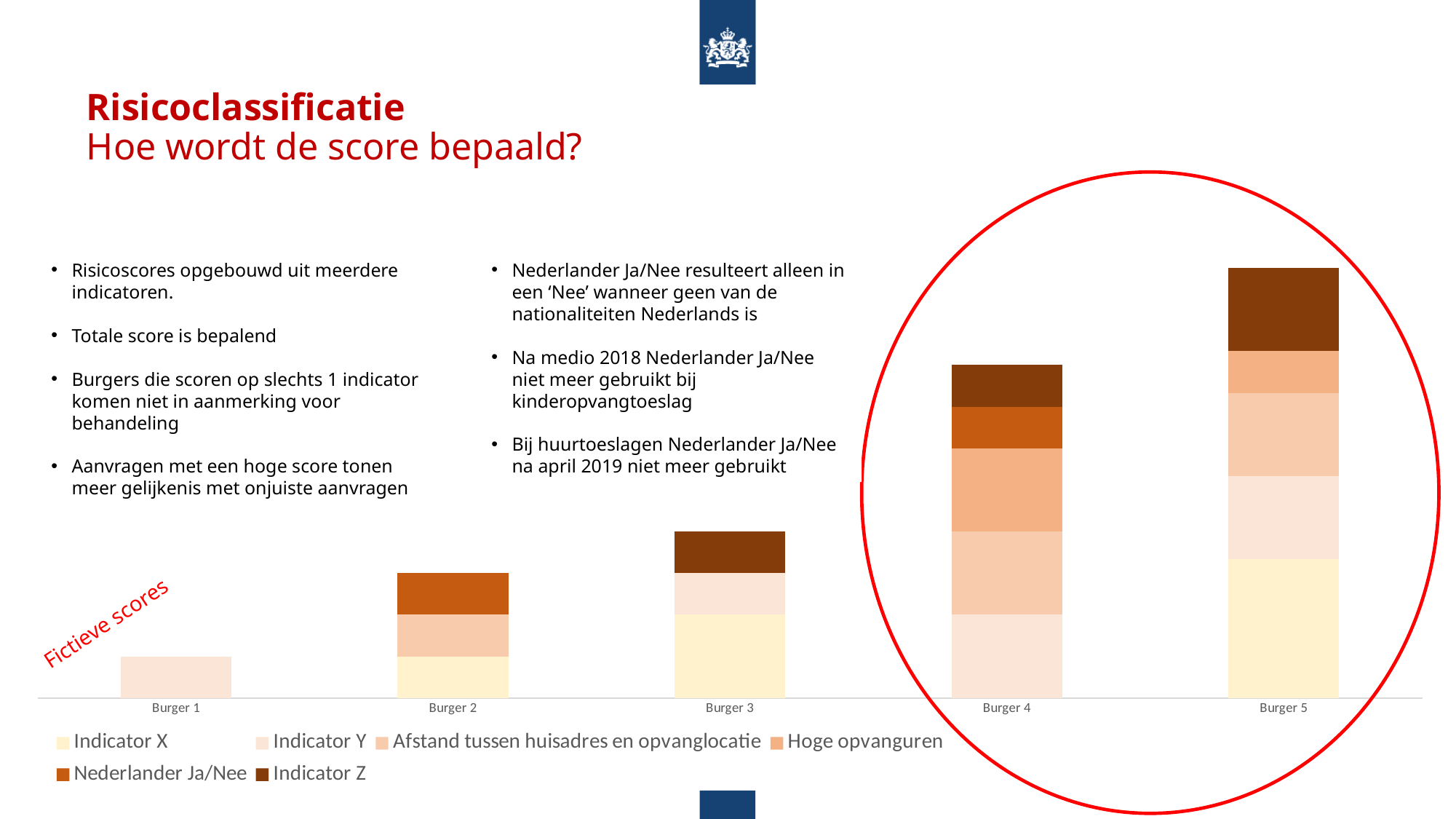
How many stacked segments make up the bar for Burger 1? 1 How many categories (burgers) are shown on the x axis of the chart? 5 Which two burgers are enclosed by the red circle on the chart? Burger 4 and Burger 5 How many series does the chart legend list? 6 What kind of chart is shown on the slide? Stacked bar chart How many stacked segments make up the bar for Burger 4? 5 Do the total bar heights rise or fall from Burger 1 to Burger 5? Rise Which burger has the lowest total stacked bar? Burger 1 Which legend entry is shown in the darkest brown colour? Indicator Z Which has a taller total bar, Burger 4 or Burger 5? Burger 5 Which burger has the highest total stacked bar? Burger 5 Which has a taller total bar, Burger 1 or Burger 2? Burger 2